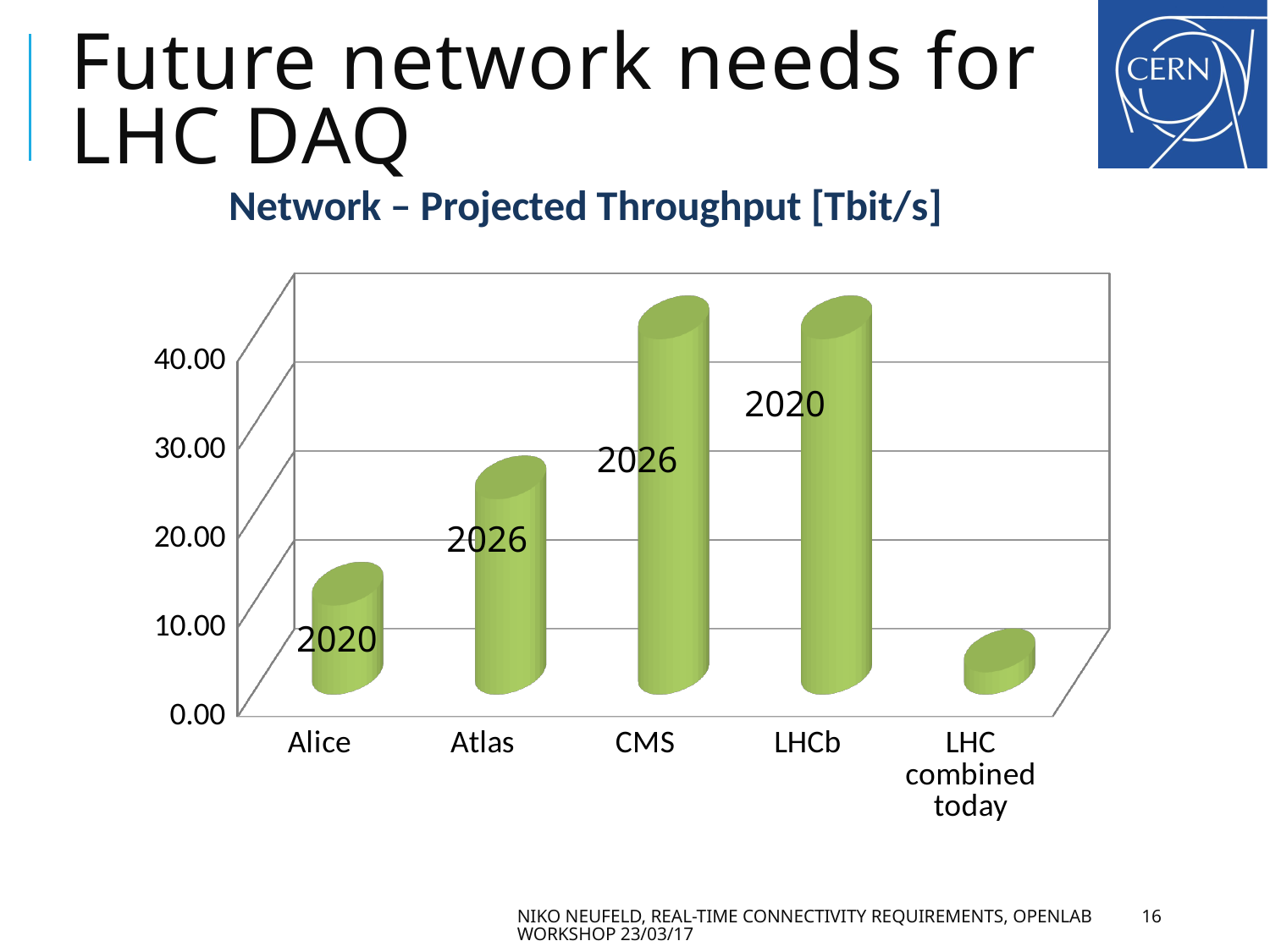
Is the value for CMS greater or less than 30? greater Is the value for LHC combined today greater or less than 10? less What year label is printed on the Atlas bar? 2026 What kind of chart is shown on the slide? bar chart Is the value for Atlas greater or less than 10? greater How many categories are shown on the x axis of the chart? 5 Which category has the lowest projected throughput? LHC combined today What is the title of the chart? Network – Projected Throughput [Tbit/s] Which has the larger projected throughput, CMS or Alice? CMS